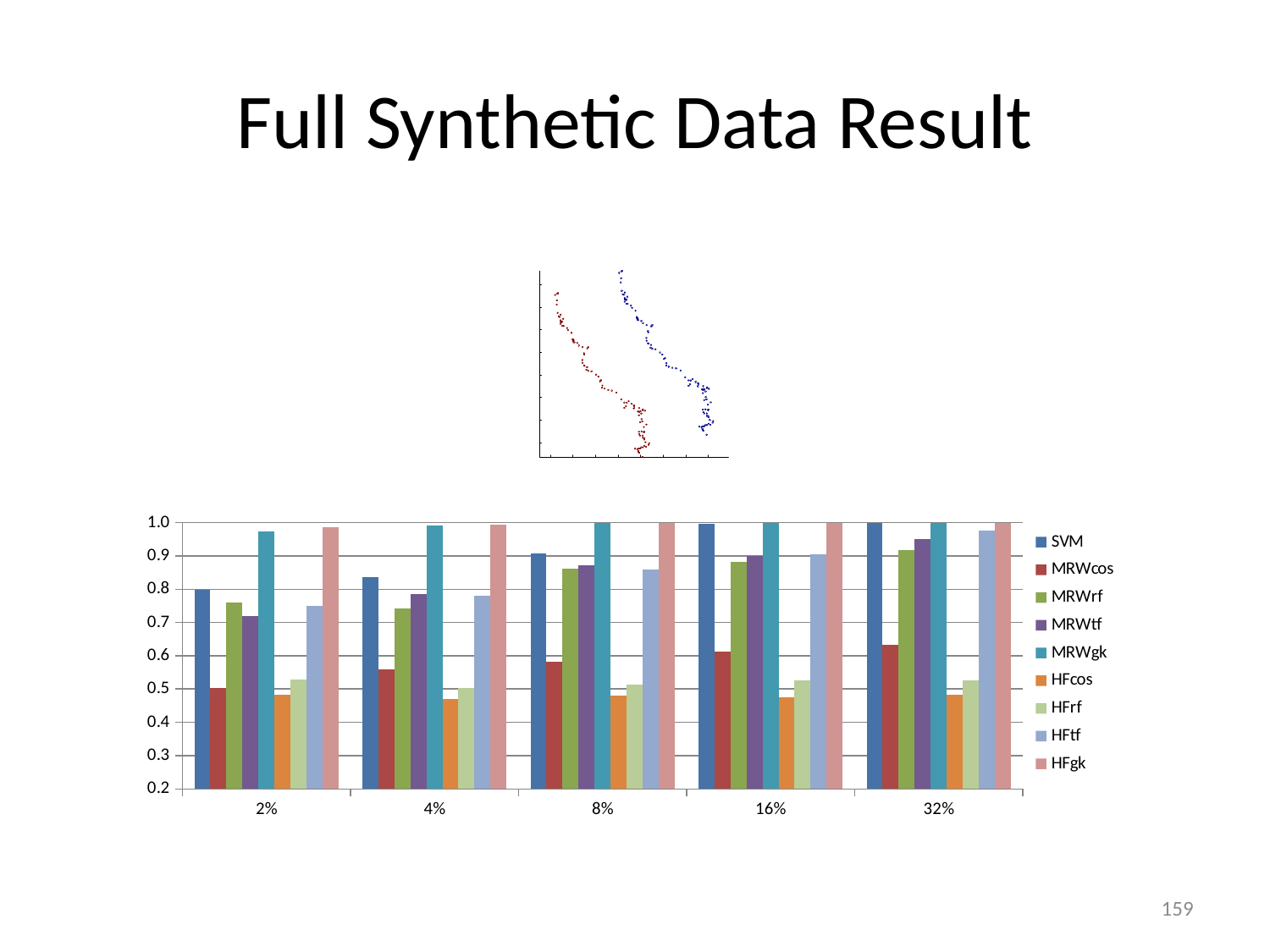
In the bar chart, at which x-axis category is the SVM value lowest? 2% In the bar chart, does the SVM series rise or fall as the x-axis percentage increases from 2% to 32%? rise In the bar chart, is the value for MRWcos at 32% greater or less than 0.7? less How many categories are shown on the x axis of the bar chart? 5 In the bar chart, is the value for HFtf at 32% greater or less than 0.9? greater How many series does the legend of the bar chart list? 9 In the bar chart, which is larger at 8%: MRWgk or HFcos? MRWgk In the bar chart, is the value for MRWrf at 2% greater or less than 0.7? greater In the bar chart, which is larger at 16%: HFrf or HFtf? HFtf What kind of chart is the large chart at the bottom of the slide? bar chart In the bar chart, which is larger at 2%: SVM or MRWcos? SVM